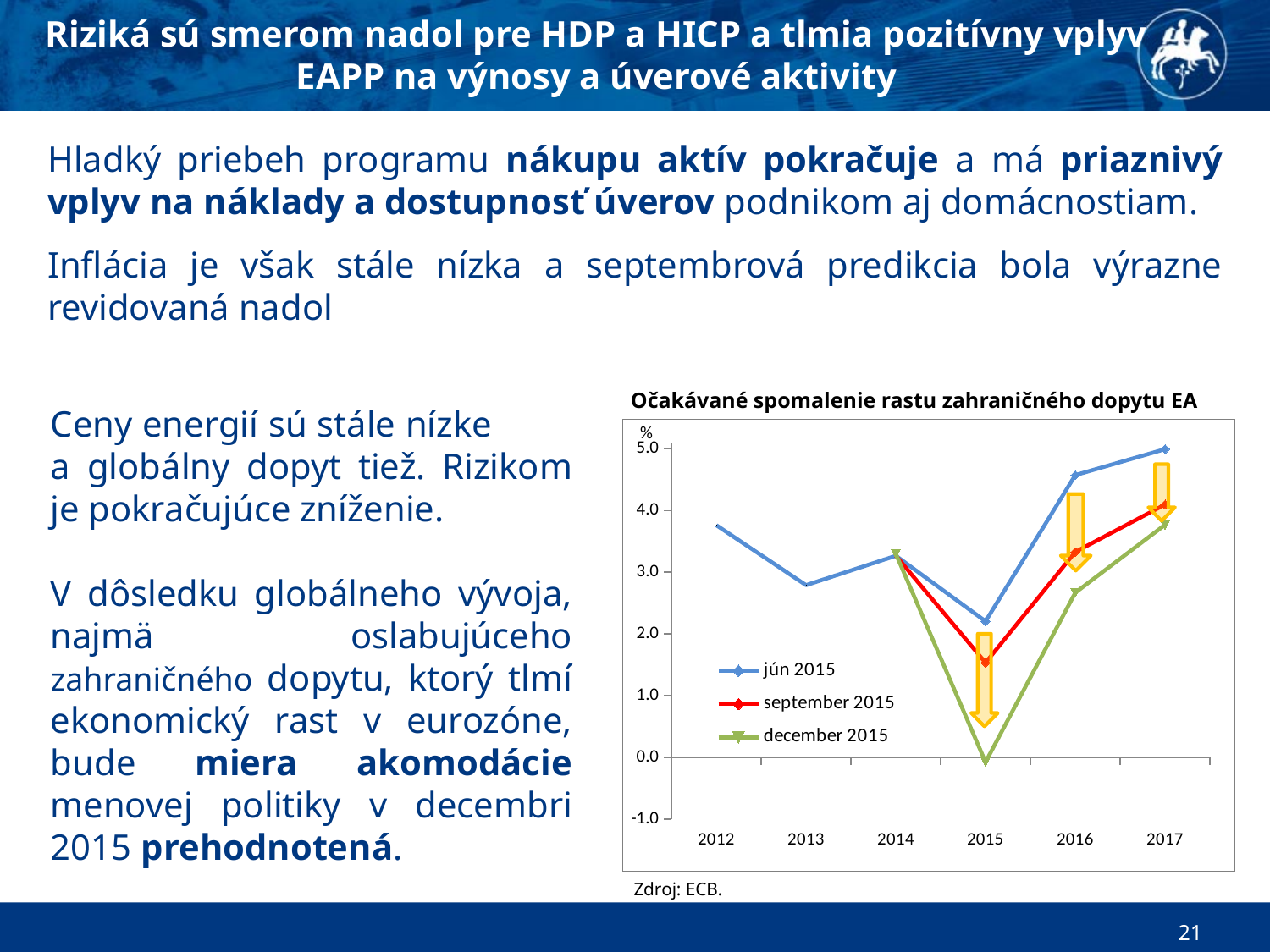
In which year does the december 2015 series reach its lowest value? 2015 What is the title of the chart? Očakávané spomalenie rastu zahraničného dopytu EA In 2015, which series has the higher value: jún 2015 or december 2015? jún 2015 What kind of chart is shown on the slide? line chart How many series does the legend of the chart list? 3 How many years are shown on the x axis of the chart? 6 Is the value of the december 2015 series for 2015 greater or less than 1.0? less What are the three series listed in the chart legend? jún 2015, september 2015, december 2015 Does the december 2015 series rise or fall from 2015 to 2017? rise Is the value of the jún 2015 series for 2017 greater or less than 4.0? greater Is the value of the september 2015 series for 2015 greater or less than 2.0? less In 2016, which series has the higher value: september 2015 or december 2015? september 2015